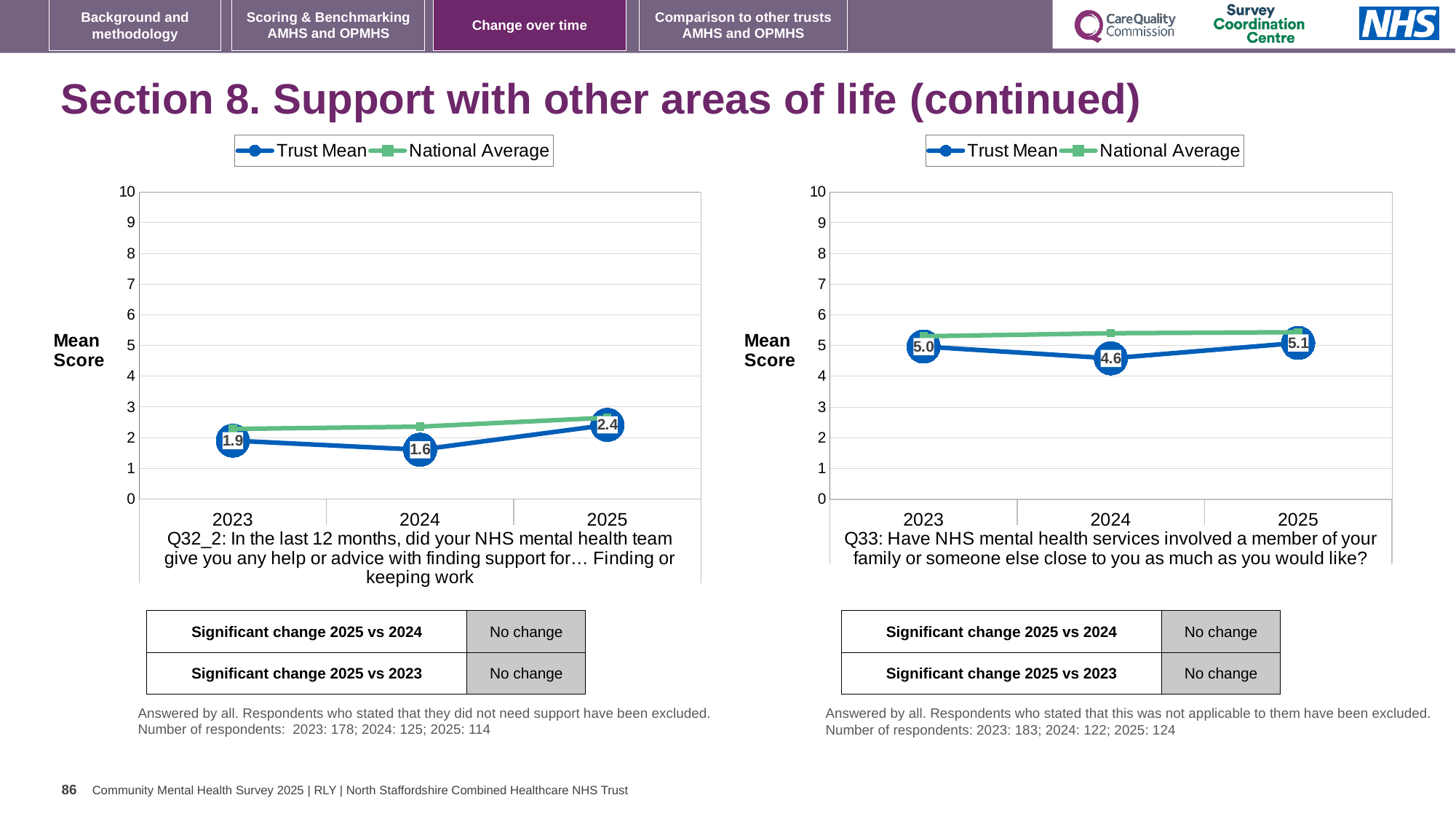
In the right chart (Q33), is the National Average for 2023 greater or less than 6? less In the right chart (Q33), which year has the lowest Trust Mean? 2024 In the right chart (Q33), which is higher in 2024: the Trust Mean or the National Average? National Average What type of chart is the left chart (Q32_2)? Line chart In the left chart (Q32_2), is the National Average for 2025 greater or less than 2? greater How many series does the legend of the right chart (Q33) list? 2 In the left chart (Q32_2), what is the Trust Mean for 2024? 1.6 In the right chart (Q33), what is the difference between the Trust Mean in 2023 and in 2024? 0.4 How many years are plotted on the x axis of the left chart (Q32_2)? 3 In the right chart (Q33), what is the Trust Mean for 2025? 5.1 In the left chart (Q32_2), what is the difference between the Trust Mean in 2025 and in 2024? 0.8 In the left chart (Q32_2), which year has the highest Trust Mean? 2025